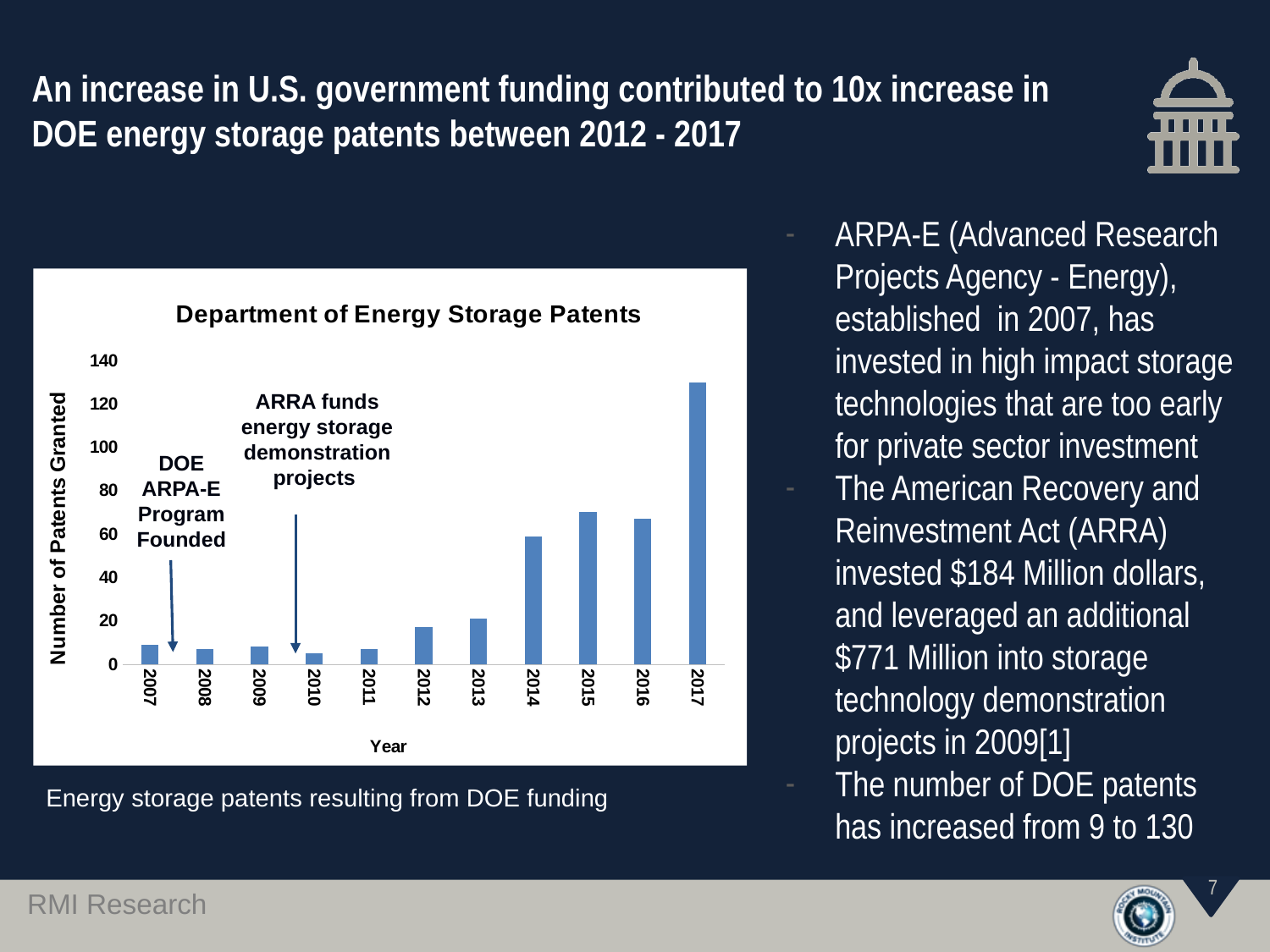
Is the value for 2015 greater or less than 60? greater Is the value for 2007 greater or less than 20? less Which year has more patents granted, 2014 or 2015? 2015 What is the label of the vertical axis of the chart? Number of Patents Granted Is the value for 2012 greater or less than 20? less How many years are shown on the x axis of the chart? 11 What is the title of the chart? Department of Energy Storage Patents Which year has the highest number of patents granted? 2017 Do the number of patents granted generally rise or fall from 2007 to 2017? Rise What type of chart is shown on the slide? Bar chart